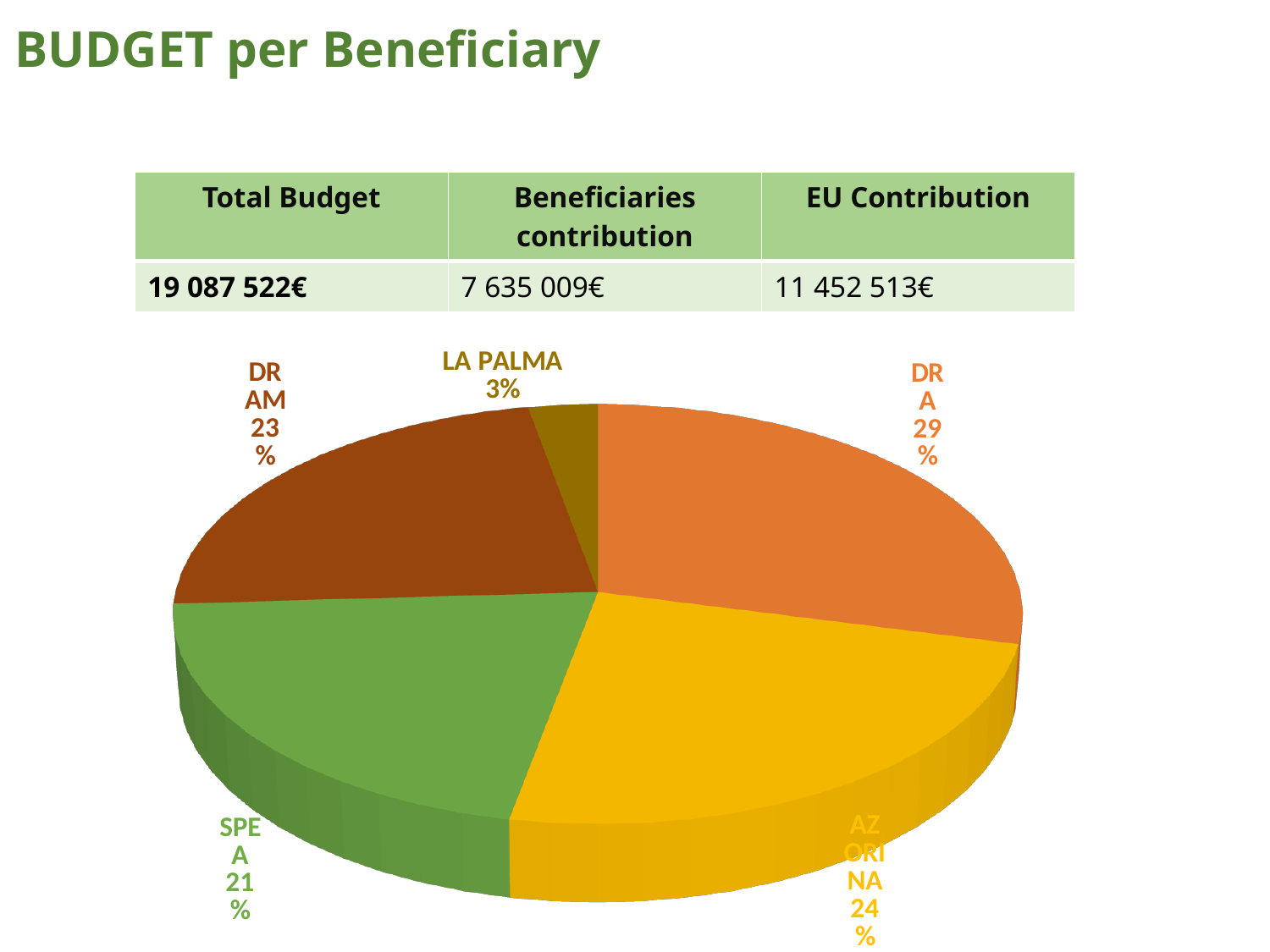
What share of the budget does DRA have in the pie chart? 29% What is the title of the slide containing the pie chart? BUDGET per Beneficiary What share of the budget does SPEA have in the pie chart? 21% Which beneficiary has the largest slice of the pie chart? DRA How many slices does the pie chart have? 5 What share of the budget does AZORINA have in the pie chart? 24% What share of the budget does DRAM have in the pie chart? 23% By how many percentage points does DRA's share exceed DRAM's share in the pie chart? 6 percentage points What kind of chart is shown on the slide? Pie chart What share of the budget does LA PALMA have in the pie chart? 3% Which beneficiary has the smallest slice of the pie chart? LA PALMA Which has the larger share in the pie chart, AZORINA or SPEA? AZORINA